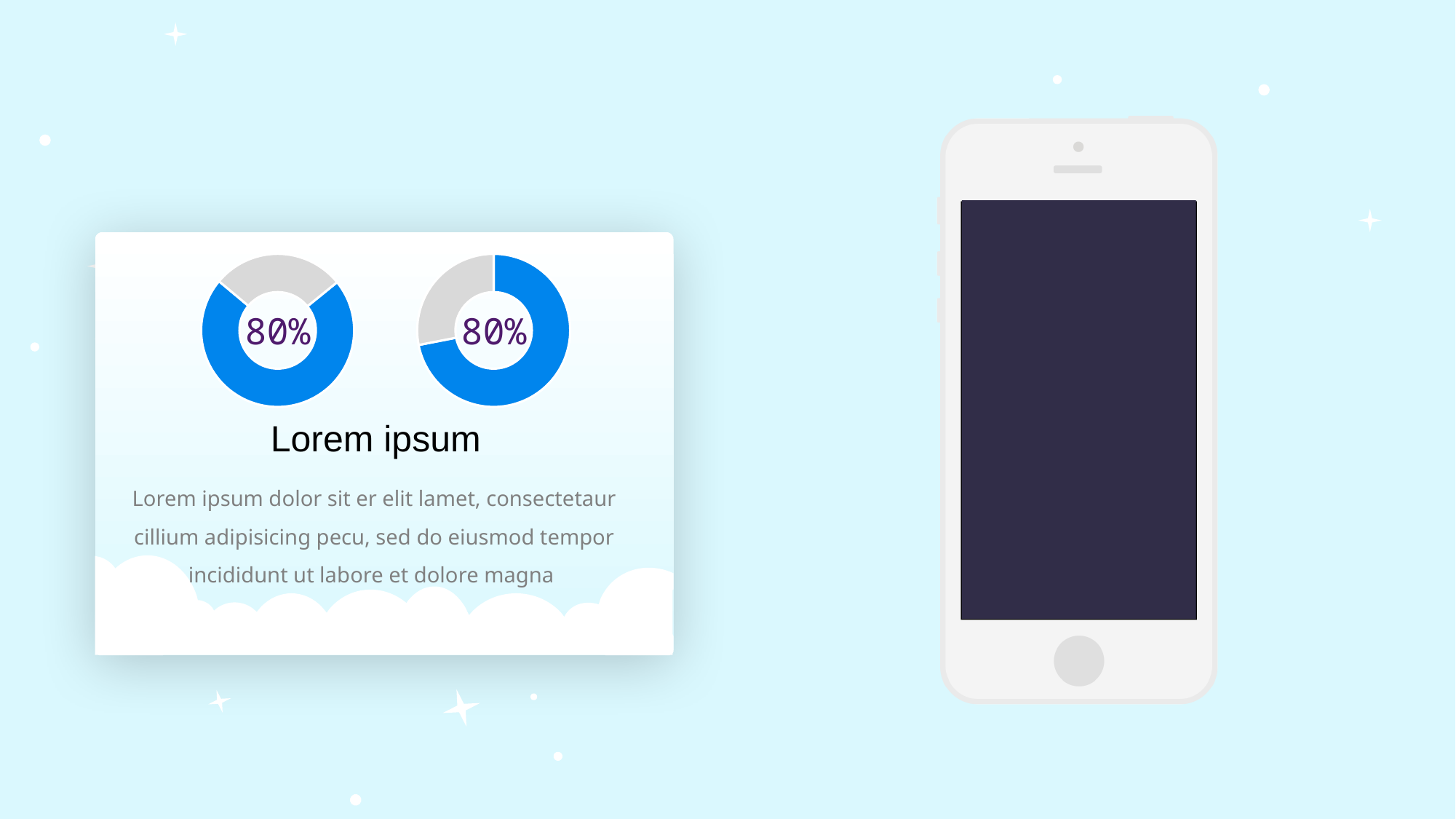
Is the percentage shown in the right donut chart greater or less than 50%? greater How many segments does each donut chart have? 2 What percentage is printed in the centre of the right donut chart? 80% What kind of chart is shown on the right of the white card? Donut chart What colour is the filled (larger) portion of the donut charts? Blue What percentage is printed in the centre of the left donut chart? 80% How many donut charts are on the slide? 2 What kind of chart is shown on the left of the white card? Donut chart What colour is the unfilled (smaller) portion of the donut charts? Grey Is the percentage shown in the left donut chart greater or less than 50%? greater